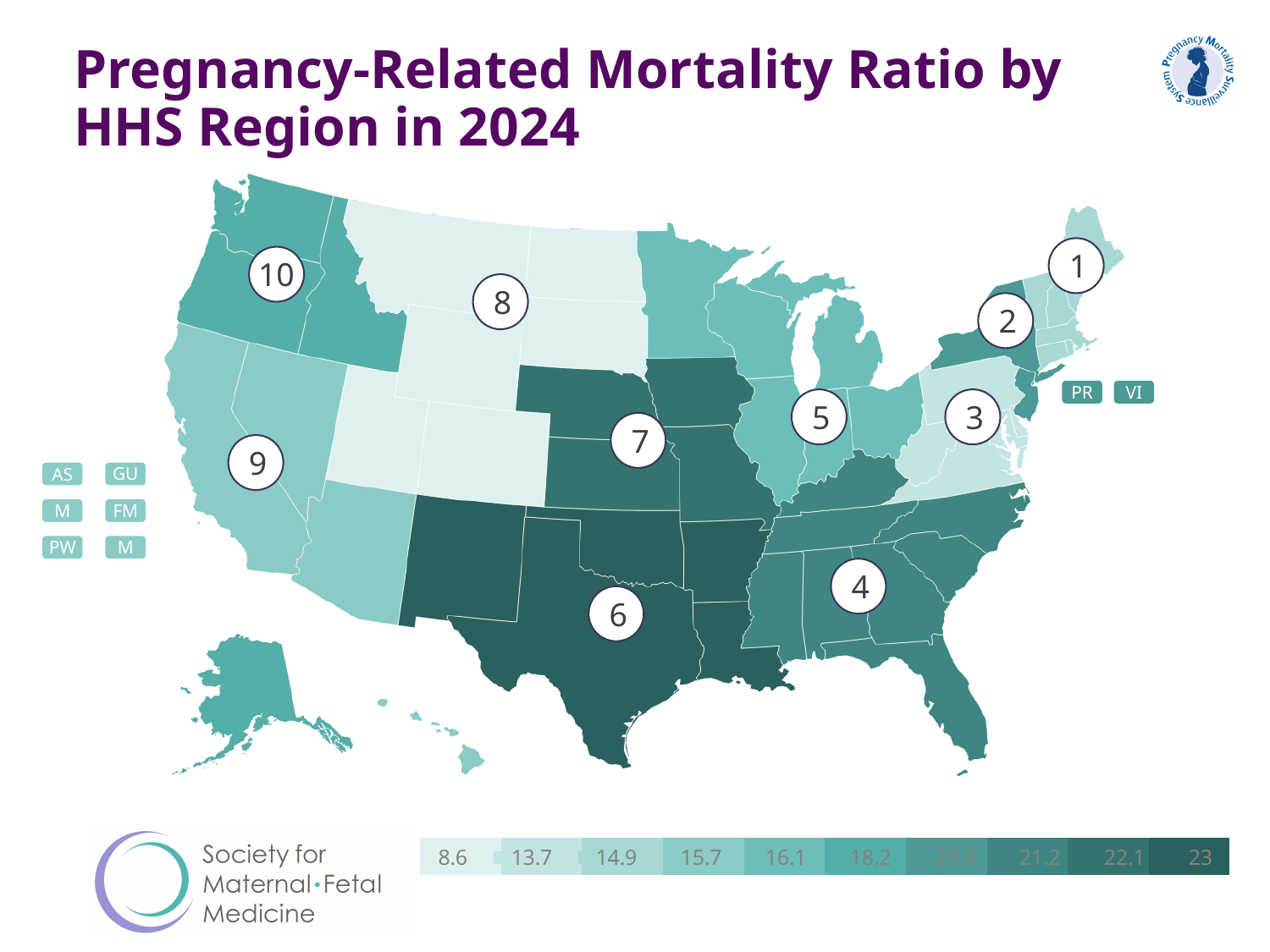
What is the difference between the highest and lowest values on the colour legend? 14.4 What kind of chart is shown on the slide? A map (choropleth map) Which has the higher pregnancy-related mortality ratio, Region 6 or Region 8? Region 6 What is the pregnancy-related mortality ratio for HHS Region 6? 23 What is the pregnancy-related mortality ratio for HHS Region 8? 8.6 How many distinct values are listed on the colour legend? 10 What is the highest value shown on the colour legend? 23 How many HHS regions are numbered on the map? 10 What is the lowest value shown on the colour legend? 8.6 Which HHS region has the highest pregnancy-related mortality ratio (darkest shading)? Region 6 Which HHS region has the lowest pregnancy-related mortality ratio (lightest shading)? Region 8 What is the title of the chart? Pregnancy-Related Mortality Ratio by HHS Region in 2024